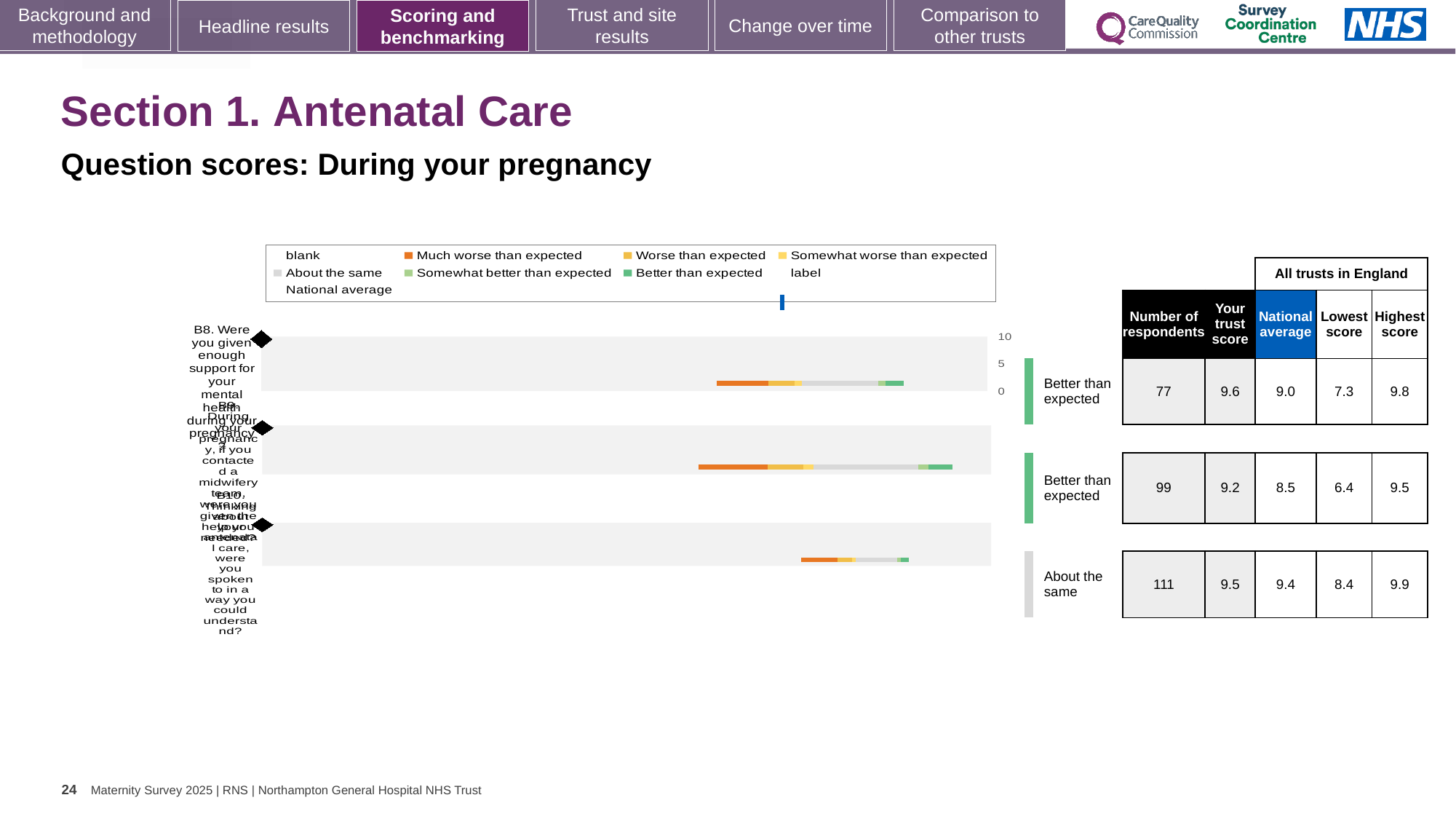
In the table beside the chart, what is the highest score in the third row? 9.9 In the table beside the chart, what is the number of respondents for the row labelled 'About the same'? 111 In the table beside the chart, what is the difference between the highest score and the lowest score in the first row? 2.5 In the table beside the chart, which row has the highest number of respondents? the third row (About the same) In the chart legend, what colour represents 'Better than expected'? green How many question bars are plotted in the chart? 3 In the chart legend, what colour represents 'Much worse than expected'? orange In the table beside the chart, which row has the smallest 'Lowest score' value? the second row In the table beside the chart, what is 'Your trust score' in the first row? 9.6 In the table beside the chart, what is the national average in the second row? 8.5 In the table beside the chart, which is larger in the second row: 'Your trust score' or the national average? Your trust score What kind of chart is shown on the slide? bar chart